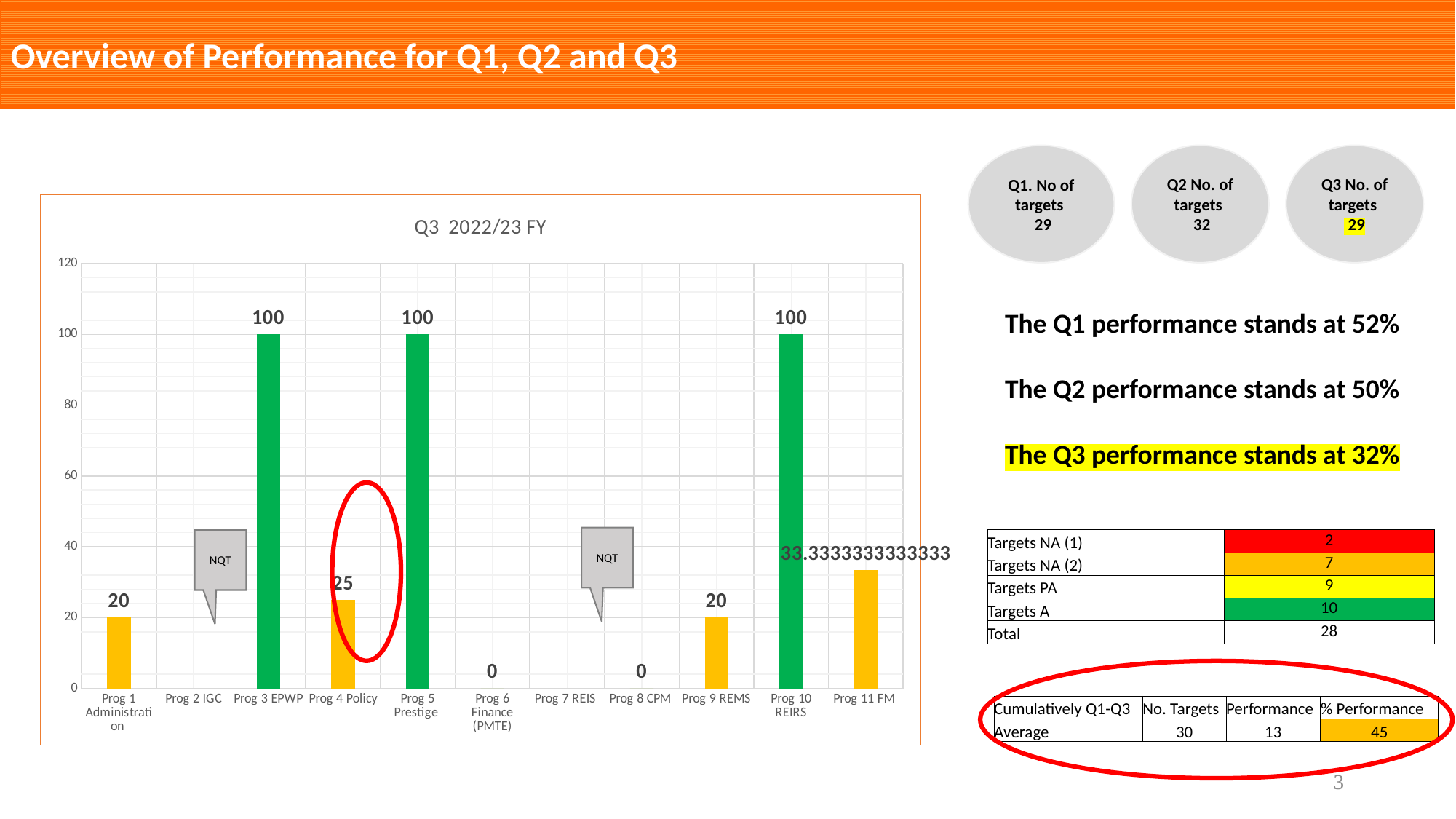
What is the title of the chart? Q3 2022/23 FY What is the difference between the values for Prog 3 EPWP and Prog 4 Policy? 75 What is the value for Prog 4 Policy? 25 What is the difference between the values for Prog 1 Administration and Prog 6 Finance (PMTE)? 20 How many categories are shown on the x axis of the chart? 11 Is the value for Prog 5 Prestige greater or less than 80? greater Which value is larger, Prog 4 Policy or Prog 9 REMS? Prog 4 Policy What is the value for Prog 8 CPM? 0 What type of chart is shown on the slide? bar chart What is the value for Prog 1 Administration? 20 What is the value for Prog 11 FM? 33.3333333333333 What label is shown in the callout boxes for Prog 2 IGC and Prog 7 REIS? NQT